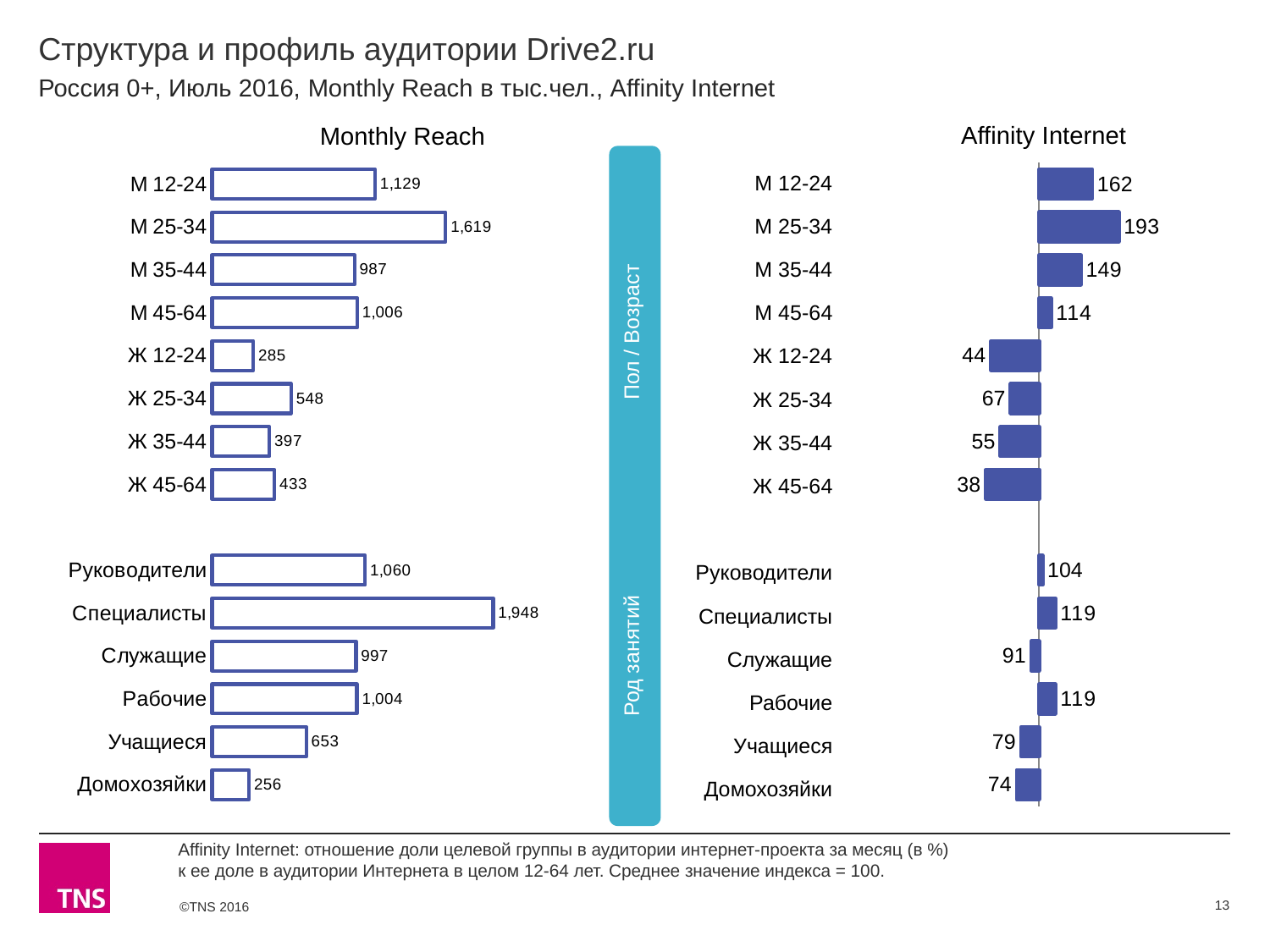
In the Monthly Reach chart, what is the value for М 25-34? 1,619 In the Monthly Reach chart, which is larger, Руководители or Рабочие? Руководители In the Monthly Reach chart, what is the difference between М 25-34 and М 12-24? 490 How many categories are shown in the Monthly Reach chart? 14 In the Monthly Reach chart, which category has the highest value? Специалисты What type of chart is the Affinity Internet chart? Bar chart In the Affinity Internet chart, what is the value for Ж 45-64? 38 In the Monthly Reach chart, what is the value for Домохозяйки? 256 In the Affinity Internet chart, which category has the lowest value? Ж 45-64 In the Affinity Internet chart, which category has the highest value? М 25-34 In the Affinity Internet chart, what is the difference between М 12-24 and Ж 12-24? 118 In the Affinity Internet chart, what is the value for Рабочие? 119